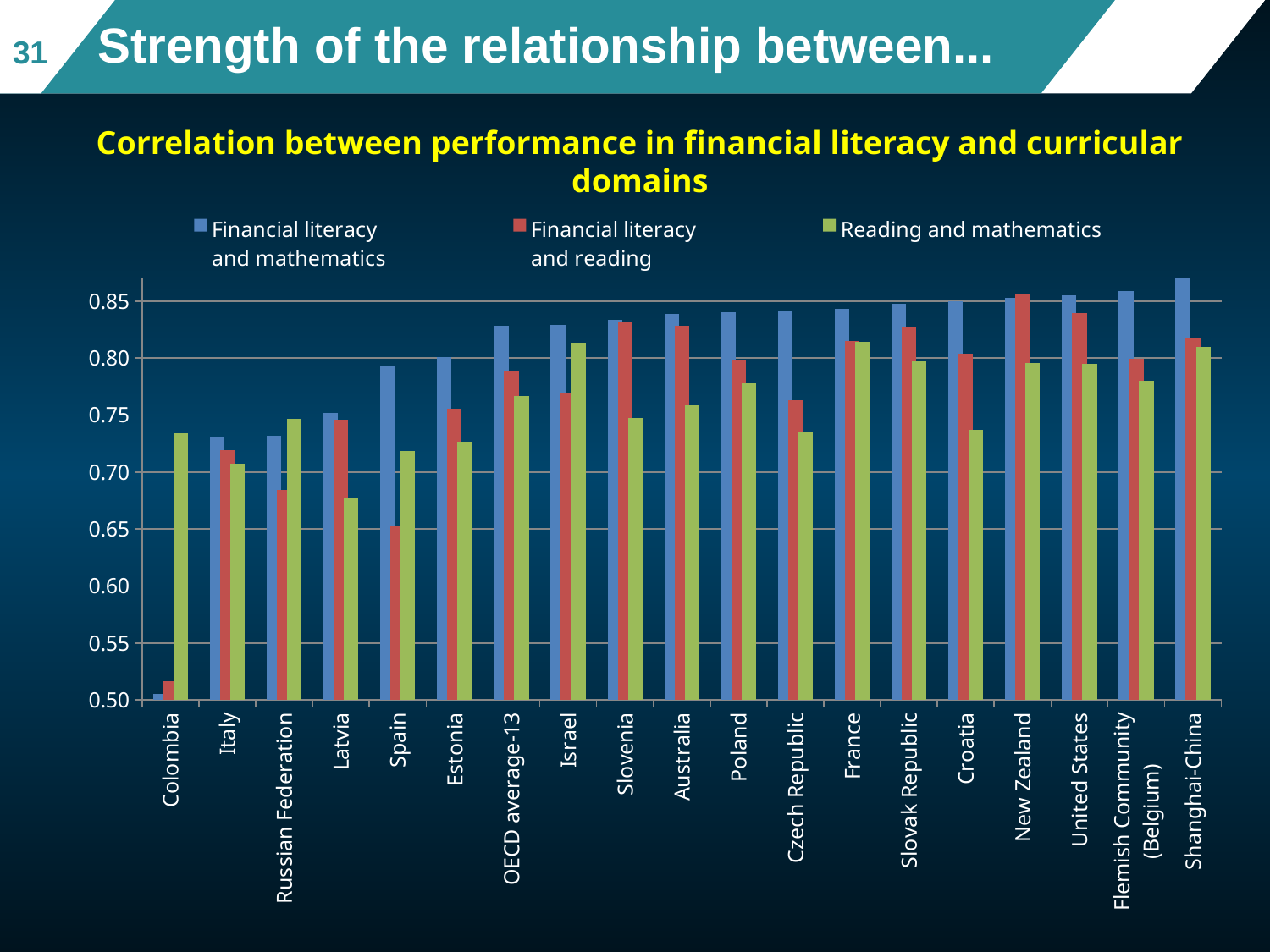
Is the value for Financial literacy and reading in Spain greater or less than 0.70? less Which category has the highest value for Financial literacy and reading? New Zealand Which category has the highest value for Financial literacy and mathematics? Shanghai-China Do the Financial literacy and mathematics values rise or fall from left to right along the x axis? rise For Colombia, which is larger: Reading and mathematics or Financial literacy and reading? Reading and mathematics Which category has the lowest value for Financial literacy and reading? Colombia Which category has the lowest value for Financial literacy and mathematics? Colombia Is the value for Financial literacy and mathematics in Shanghai-China greater or less than 0.85? greater How many series does the legend list? 3 Which category has the lowest value for Reading and mathematics? Latvia How many countries/categories are shown on the x axis? 19 What kind of chart is shown on the slide? bar chart